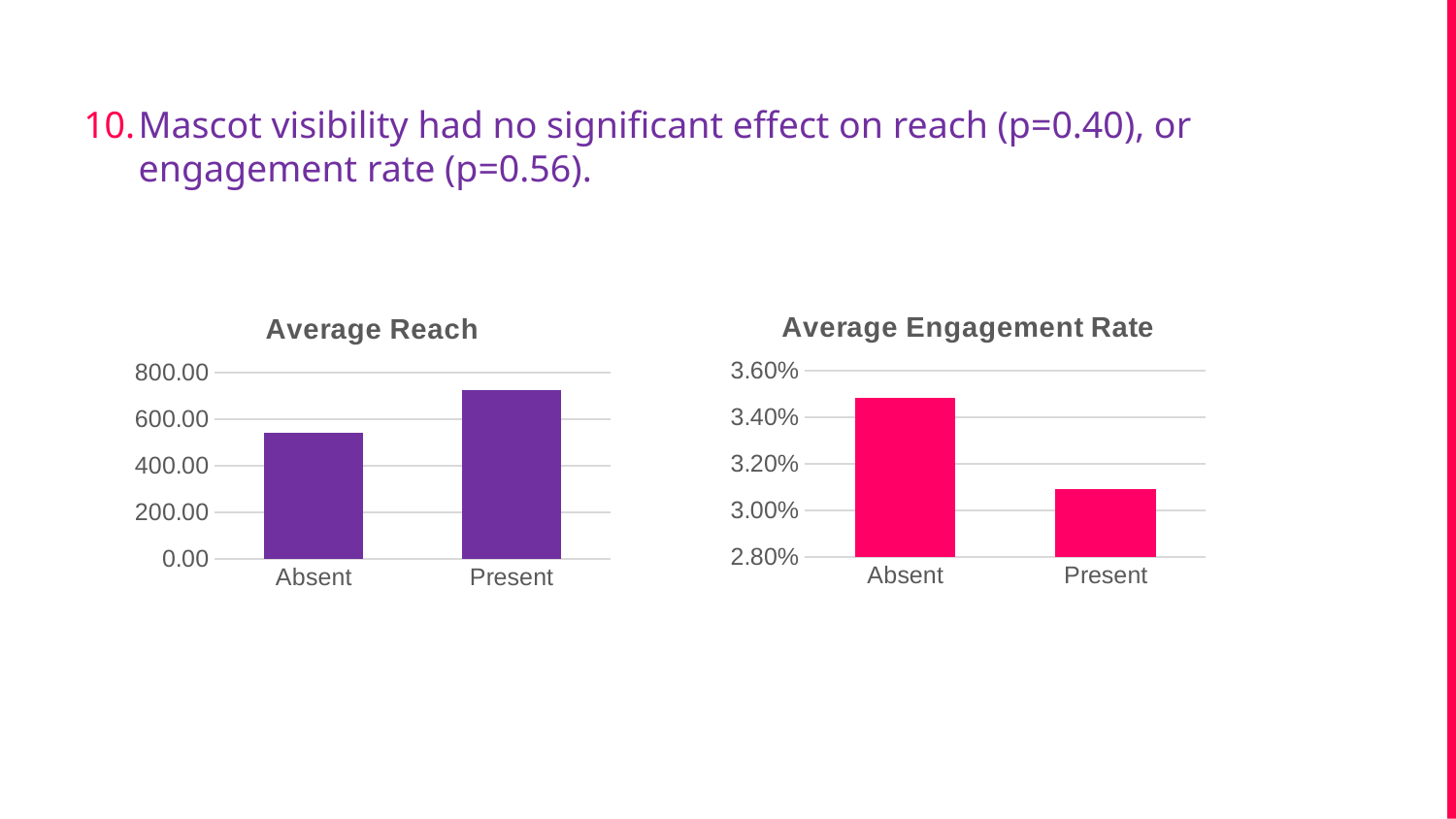
In the Average Reach chart, is the value for Present greater or less than 600.00? greater In the Average Engagement Rate chart, is the value for Present greater or less than 3.20%? less What kind of chart is the Average Reach chart? bar chart In the Average Reach chart, is the value for Absent greater or less than 600.00? less In the Average Engagement Rate chart, which category has the lower value? Present In the Average Reach chart, how many categories are shown? 2 In the Average Engagement Rate chart, do the values rise or fall from Absent to Present? fall In the Average Engagement Rate chart, which category has the higher value? Absent In the Average Reach chart, which category has the lower value? Absent What is the title of the chart on the right side of the slide? Average Engagement Rate In the Average Reach chart, which category has the higher value? Present